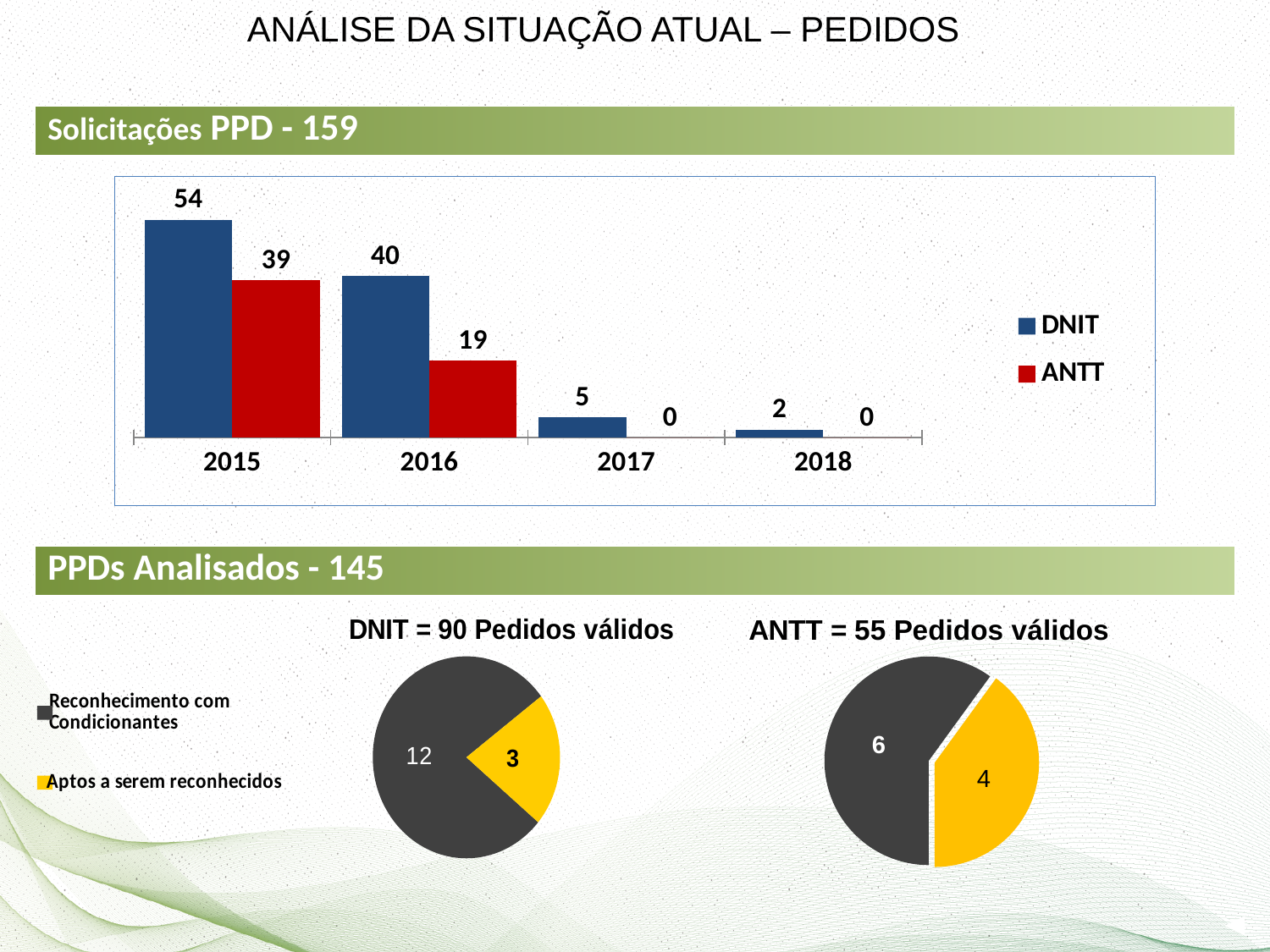
In the bar chart under 'Solicitações PPD - 159', do the DNIT values rise or fall from 2015 to 2018? Fall In the pie chart titled 'DNIT = 90 Pedidos válidos', what is the value of the 'Aptos a serem reconhecidos' slice? 3 In the bar chart under 'Solicitações PPD - 159', which is larger in 2016: DNIT or ANTT? DNIT In the bar chart under 'Solicitações PPD - 159', how many years are shown on the x axis? 4 In the pie chart titled 'ANTT = 55 Pedidos válidos', what is the value of the 'Reconhecimento com Condicionantes' slice? 6 In the bar chart under 'Solicitações PPD - 159', which year has the highest DNIT value? 2015 What kind of chart is shown under 'Solicitações PPD - 159'? Bar chart In the bar chart under 'Solicitações PPD - 159', what is the difference between the DNIT and ANTT values for 2015? 15 In the bar chart under 'Solicitações PPD - 159', which year has the lowest DNIT value? 2018 In the bar chart under 'Solicitações PPD - 159', what is the DNIT value for 2015? 54 In the bar chart under 'Solicitações PPD - 159', what is the ANTT value for 2016? 19 In the bar chart under 'Solicitações PPD - 159', how many series does the legend list? 2